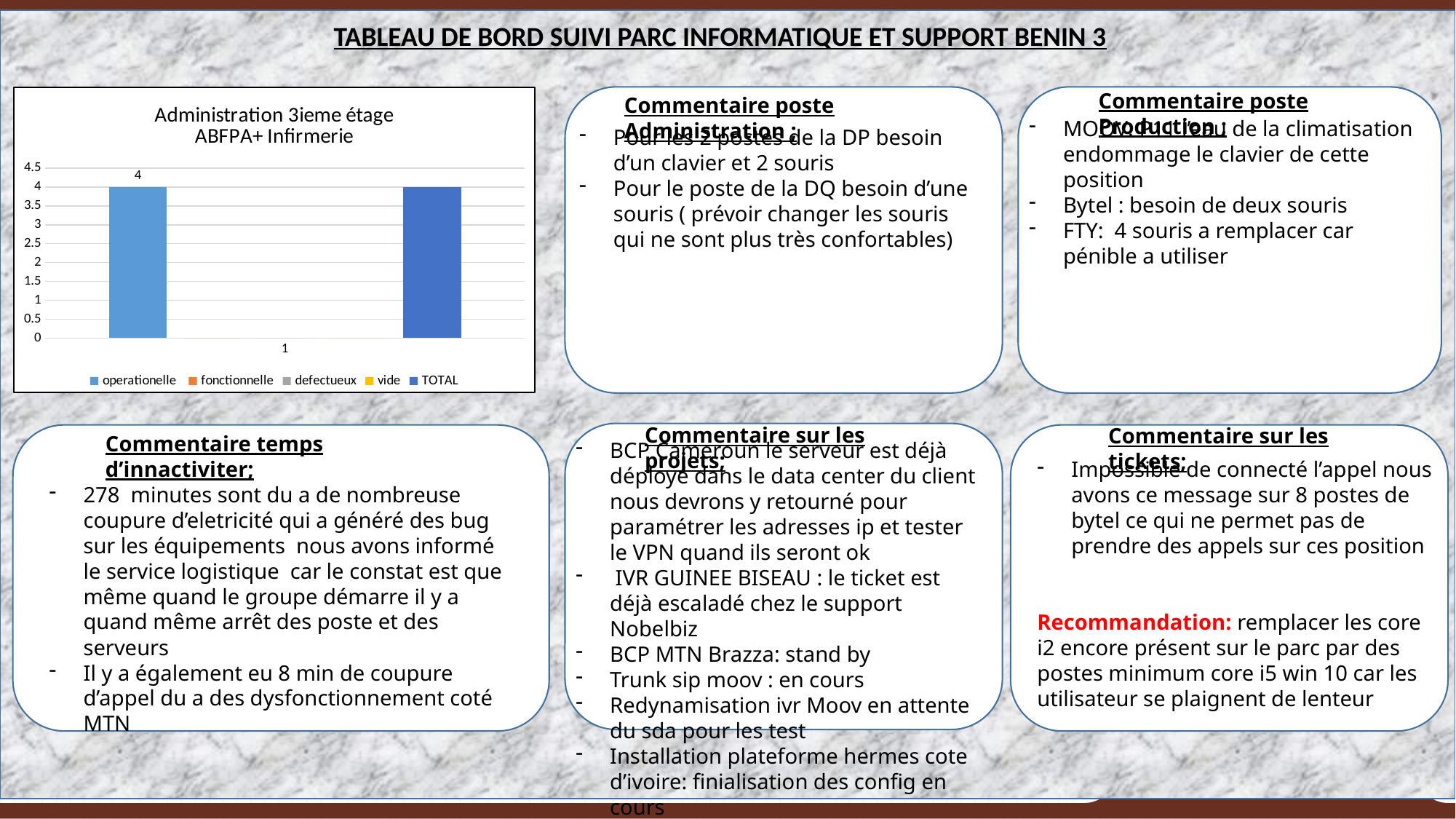
Which series has the lowest value in the chart, operationelle or vide? vide What is the value of the operationelle series in the chart? 4 Is the value for operationelle greater or less than 2? greater What is the value of the TOTAL series in the chart? 4 What kind of chart is shown on the slide? bar chart How many categories are shown on the x axis of the chart? 1 Which is larger, the operationelle value or the fonctionnelle value? operationelle How many series does the chart legend list? 5 What is the difference between the operationelle value and the TOTAL value? 0 What is the highest value shown on the chart's y axis? 4.5 What is the title of the chart? Administration 3ieme étage ABFPA+ Infirmerie Is the value for TOTAL greater or less than 3? greater